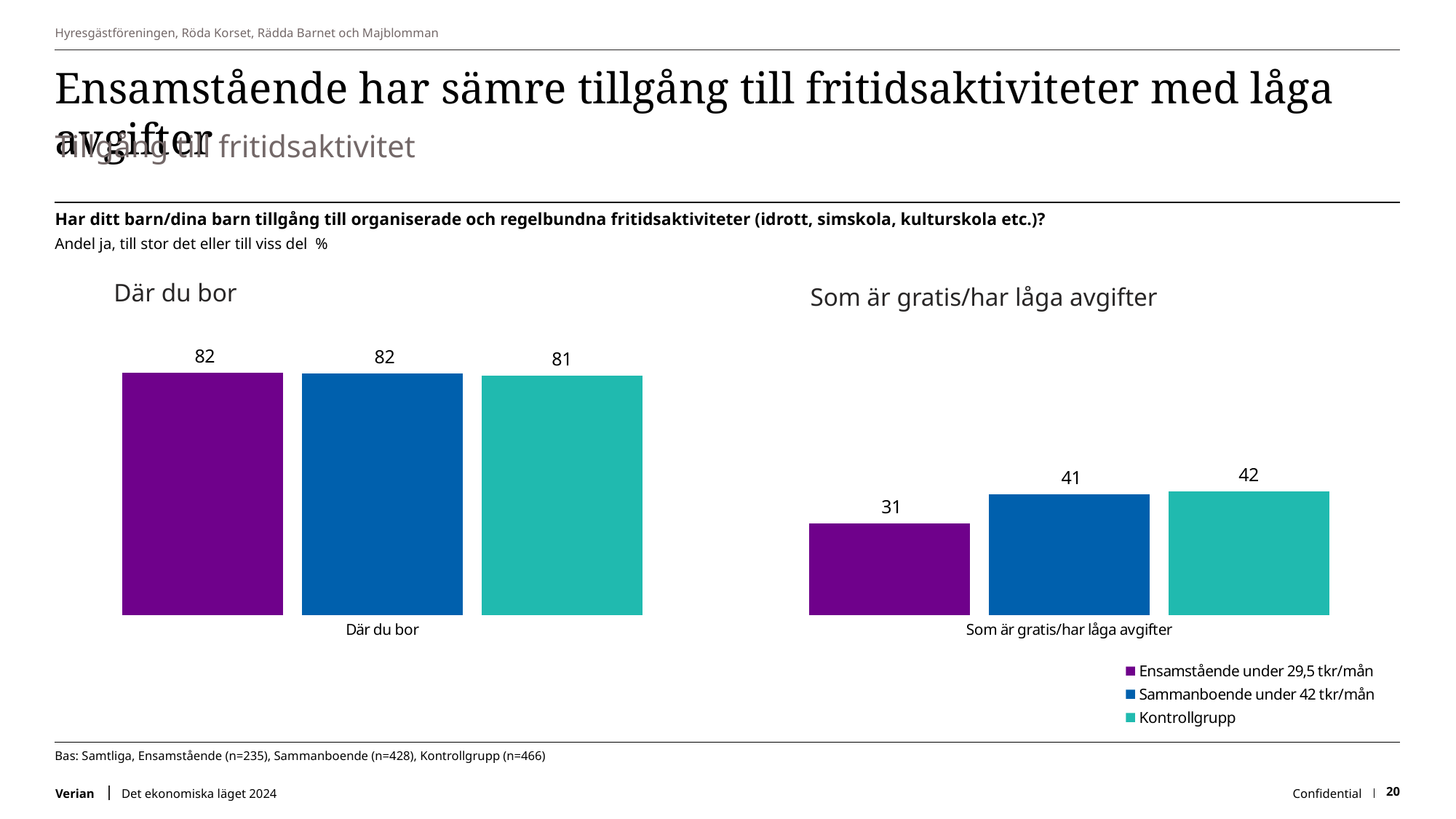
In the 'Som är gratis/har låga avgifter' chart, what is the difference between the values for Kontrollgrupp and Ensamstående under 29,5 tkr/mån? 11 In the 'Som är gratis/har låga avgifter' chart, what is the difference between Sammanboende under 42 tkr/mån and Ensamstående under 29,5 tkr/mån? 10 How many series does the legend list? 3 What type of chart is the 'Där du bor' chart? Bar chart In the 'Som är gratis/har låga avgifter' chart, which group has the lowest value? Ensamstående under 29,5 tkr/mån In the 'Som är gratis/har låga avgifter' chart, what is the value for Ensamstående under 29,5 tkr/mån? 31 In the 'Där du bor' chart, what is the value for Sammanboende under 42 tkr/mån? 82 How many bars are shown in the 'Där du bor' chart? 3 In the 'Där du bor' chart, what is the value for Kontrollgrupp? 81 Which colour represents Kontrollgrupp in the legend? Teal In the 'Som är gratis/har låga avgifter' chart, which is larger: the value for Sammanboende under 42 tkr/mån or for Ensamstående under 29,5 tkr/mån? Sammanboende under 42 tkr/mån In the 'Som är gratis/har låga avgifter' chart, what is the value for Kontrollgrupp? 42